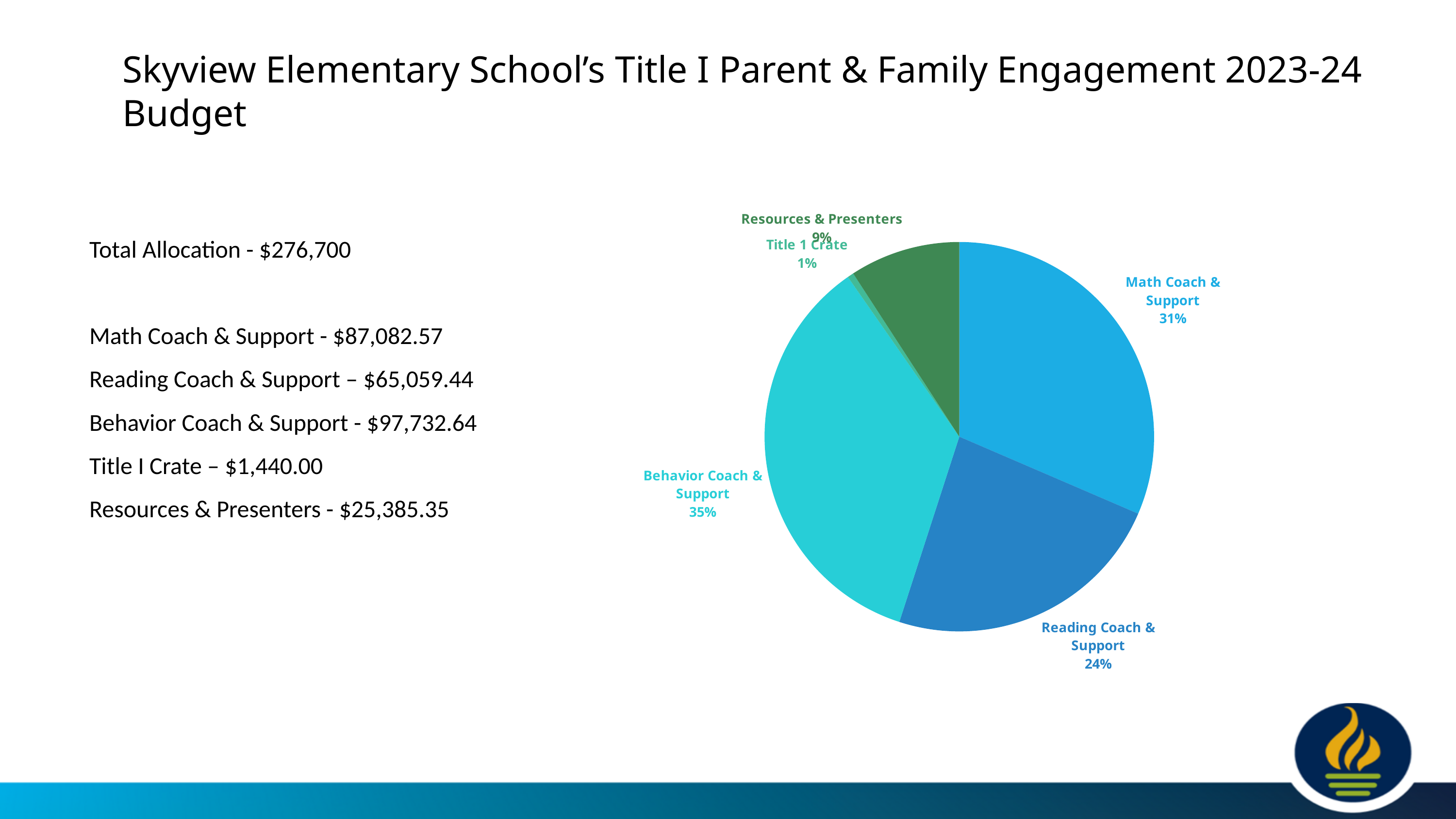
What is the difference in percentage points between the Behavior Coach & Support slice and the Reading Coach & Support slice? 11 What share of the pie does Behavior Coach & Support take? 35% What share of the pie does Reading Coach & Support take? 24% What share of the pie does Resources & Presenters take? 9% How many slices does the pie chart have? 5 Which slice of the pie chart is the smallest? Title 1 Crate Which slice of the pie chart is the largest? Behavior Coach & Support Which slice is larger, Math Coach & Support or Reading Coach & Support? Math Coach & Support Which slice is larger, Resources & Presenters or Title 1 Crate? Resources & Presenters What kind of chart is shown on the slide? pie chart